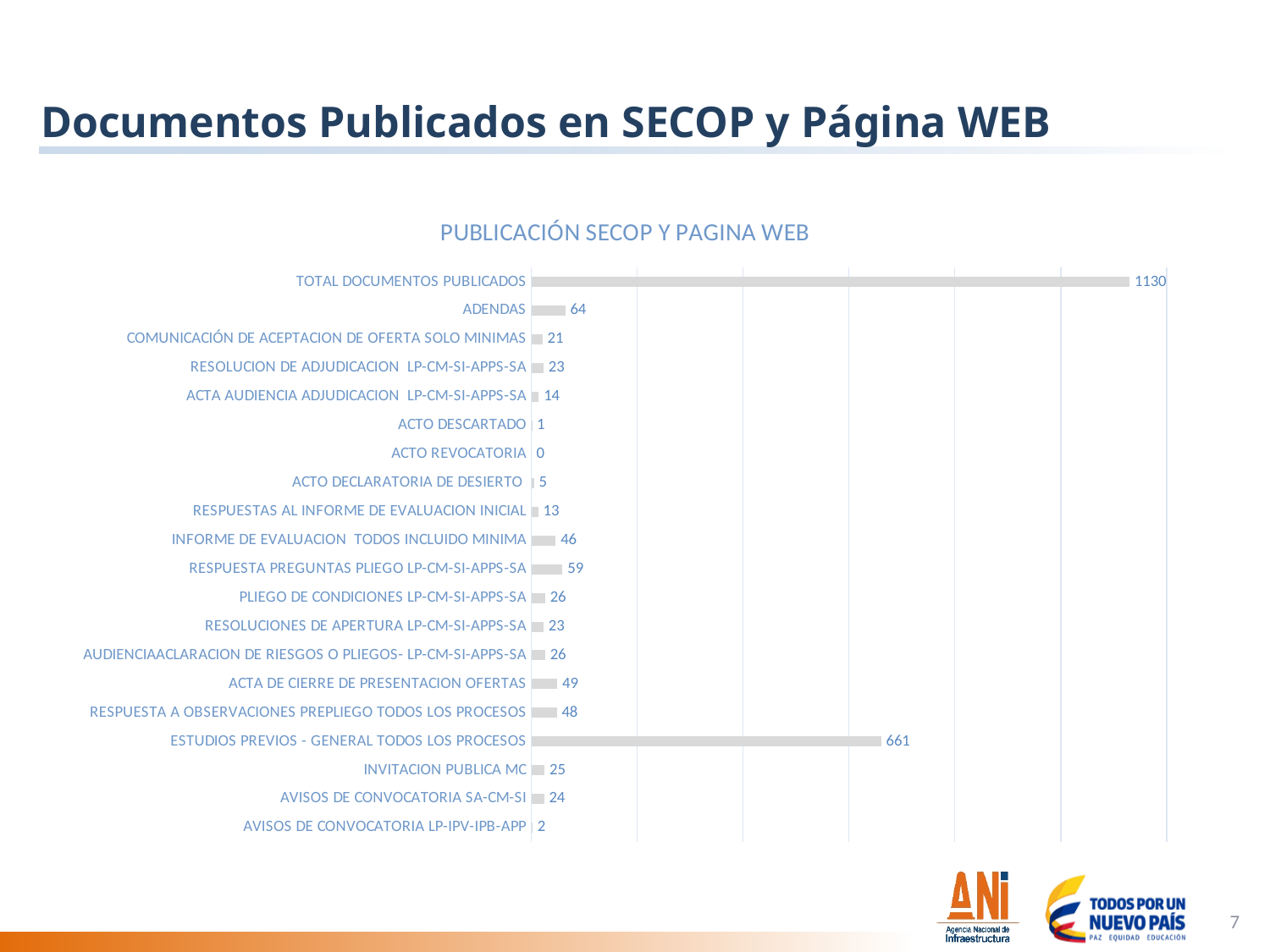
What is the value for ACTO REVOCATORIA? 0 What is the value for ACTA DE CIERRE DE PRESENTACION OFERTAS? 49 What is the value for TOTAL DOCUMENTOS PUBLICADOS? 1130 How many categories are shown in the chart? 20 What is the title of the chart? PUBLICACIÓN SECOP Y PAGINA WEB What is the difference between TOTAL DOCUMENTOS PUBLICADOS and ESTUDIOS PREVIOS - GENERAL TODOS LOS PROCESOS? 469 What is the value for ESTUDIOS PREVIOS - GENERAL TODOS LOS PROCESOS? 661 Which category has the lowest value? ACTO REVOCATORIA Which is larger, ADENDAS or RESPUESTA PREGUNTAS PLIEGO LP-CM-SI-APPS-SA? ADENDAS Which category has the highest value? TOTAL DOCUMENTOS PUBLICADOS What kind of chart is shown on the slide? Bar chart What is the value for ADENDAS? 64